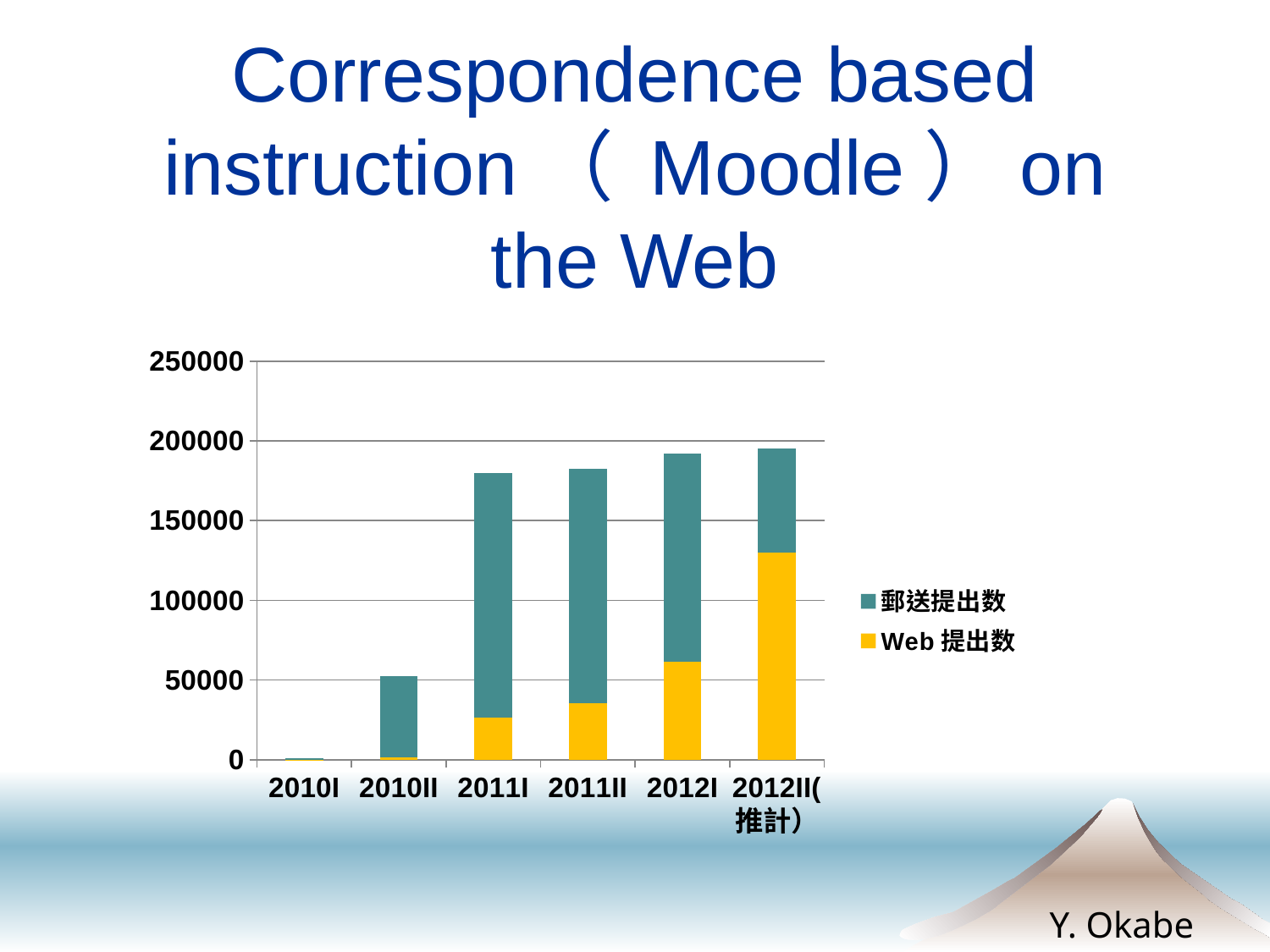
Is the total value for 2011I greater or less than 150000? greater Which is larger, the Web 提出数 value for 2012I or for 2012II(推計)? 2012II(推計) Is the Web 提出数 value for 2012II(推計) greater or less than 100000? greater How many series does the chart's legend list? 2 Do the total bar heights rise or fall from 2010I to 2012II(推計)? rise Is the Web 提出数 value for 2011I greater or less than 50000? less What kind of chart is shown on the slide? Stacked bar chart How many categories are shown on the x axis of the chart? 6 Which category has the tallest stacked bar overall? 2012II(推計) Which category has the shortest stacked bar overall? 2010I Which colour represents the Web 提出数 series in the chart? Yellow